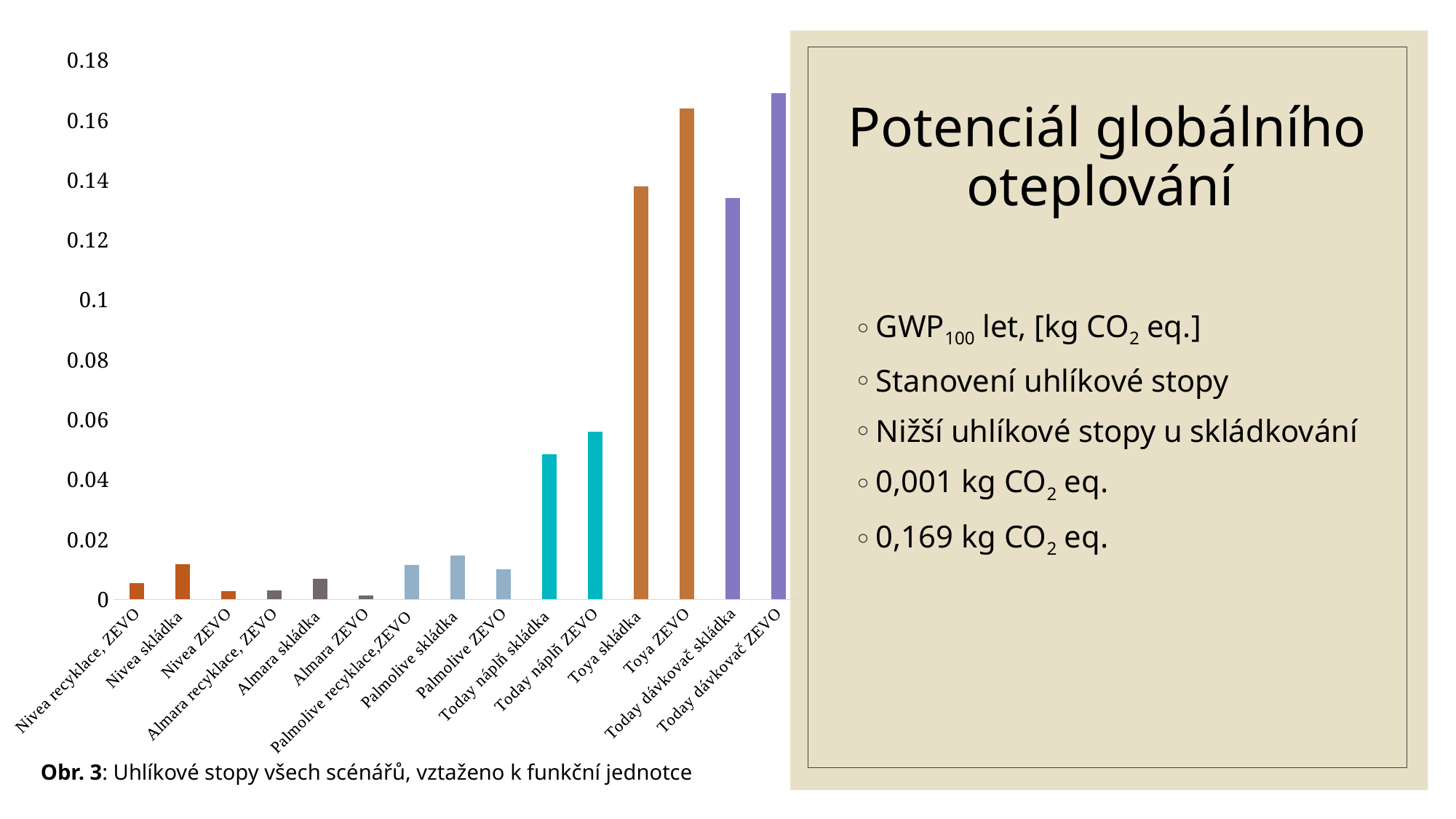
Is the value for Today náplň ZEVO greater or less than 0.04? greater Which is larger, the value for Toya ZEVO or the value for Toya skládka? Toya ZEVO Is the value for Today dávkovač skládka greater or less than 0.14? less What kind of chart is shown on the slide? bar chart What is the caption given below the chart? Obr. 3: Uhlíkové stopy všech scénářů, vztaženo k funkční jednotce Which is larger, the value for Today náplň ZEVO or the value for Today náplň skládka? Today náplň ZEVO How many categories (bars) does the chart show? 15 Is the value for Palmolive skládka greater or less than 0.02? less Which category has the highest value in the chart? Today dávkovač ZEVO Which category has the lowest value in the chart? Almara ZEVO Which is larger, the value for Nivea skládka or the value for Nivea ZEVO? Nivea skládka